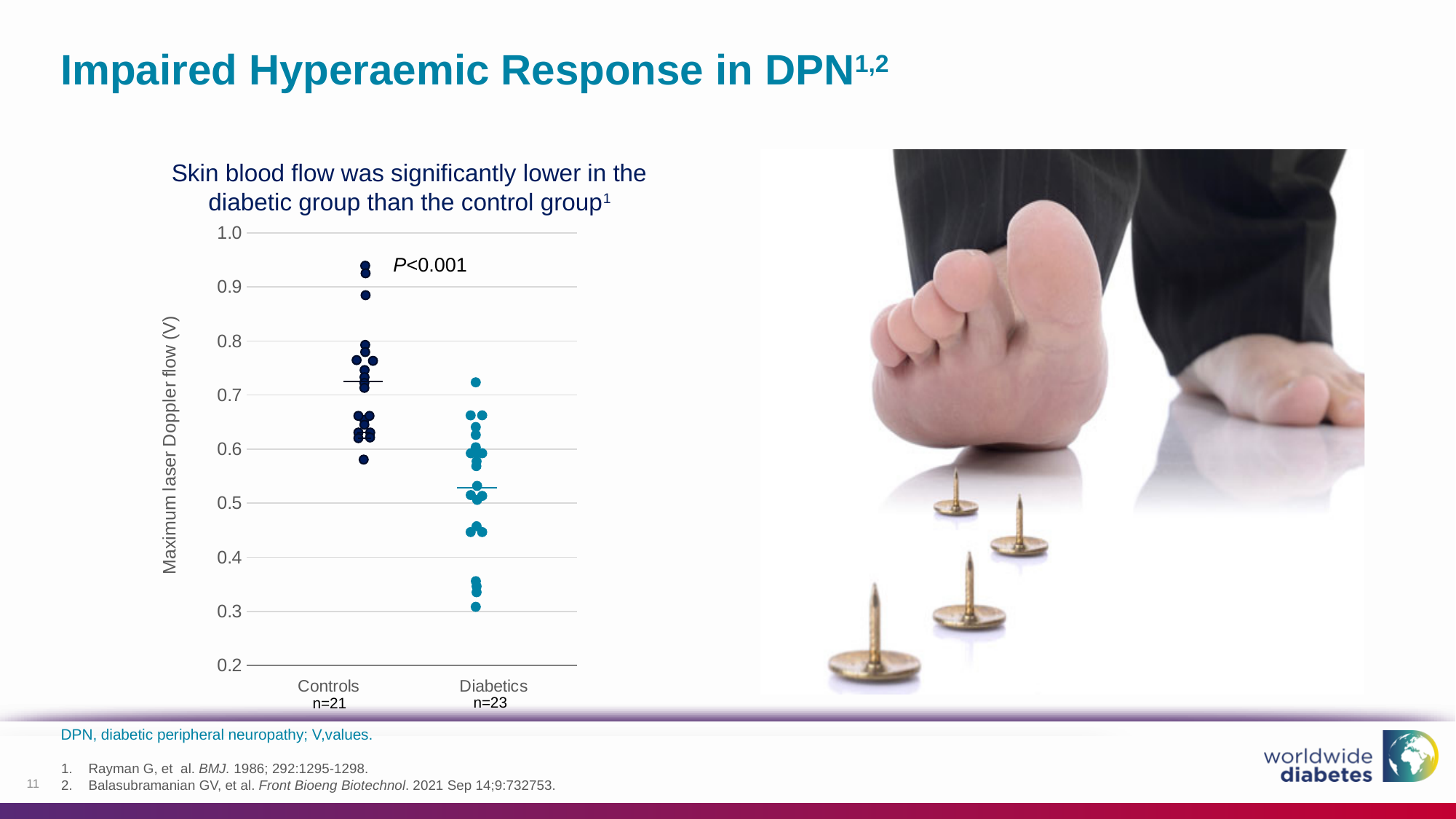
What kind of chart is shown on the slide? Dot plot (scatter plot) What is the sample size (n) for the Controls group? n=21 Is the lowest value in the Diabetics group greater or less than 0.4? less What is the label of the y axis of the chart? Maximum laser Doppler flow (V) Is the highest value in the Controls group greater or less than 0.9? greater What is the highest tick value shown on the y axis? 1.0 Which group has the higher mean maximum laser Doppler flow, Controls or Diabetics? Controls Is the mean line for the Diabetics group greater or less than 0.6? less How many groups are plotted on the x axis of the chart? 2 What is the sample size (n) for the Diabetics group? n=23 What P value is shown on the chart? P<0.001